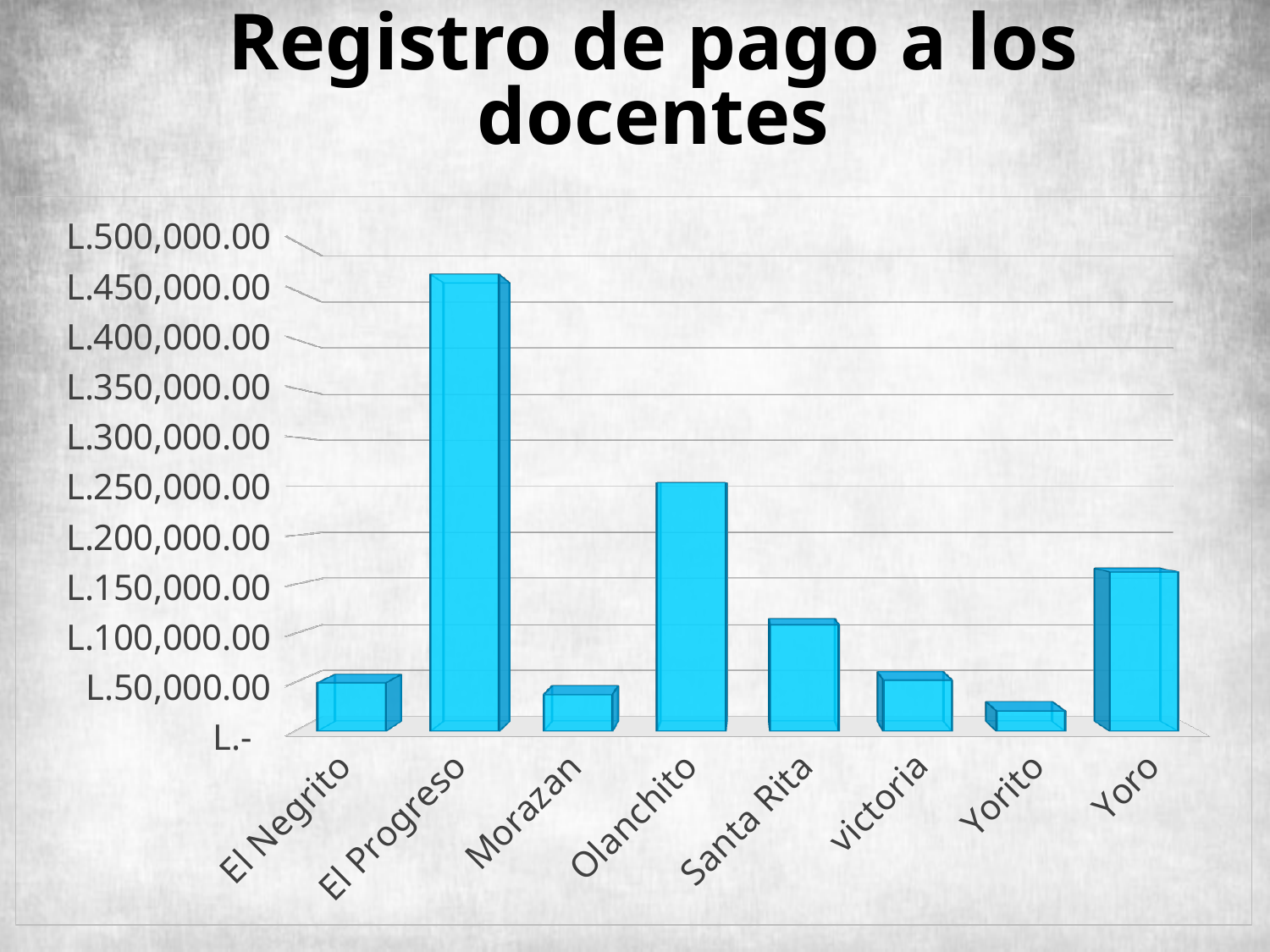
Which has a larger value, Olanchito or Yoro? Olanchito Is the value for Santa Rita greater or less than L.150,000.00? less Which category has the highest value in the chart? El Progreso How many categories are shown on the x axis of the chart? 8 What kind of chart is shown on the slide? bar chart Is the value for Yoro greater or less than L.100,000.00? greater Which category has the lowest value in the chart? Yorito Is the value for Yorito greater or less than L.50,000.00? less What is the title of the chart? Registro de pago a los docentes Which has a larger value, Santa Rita or Morazan? Santa Rita